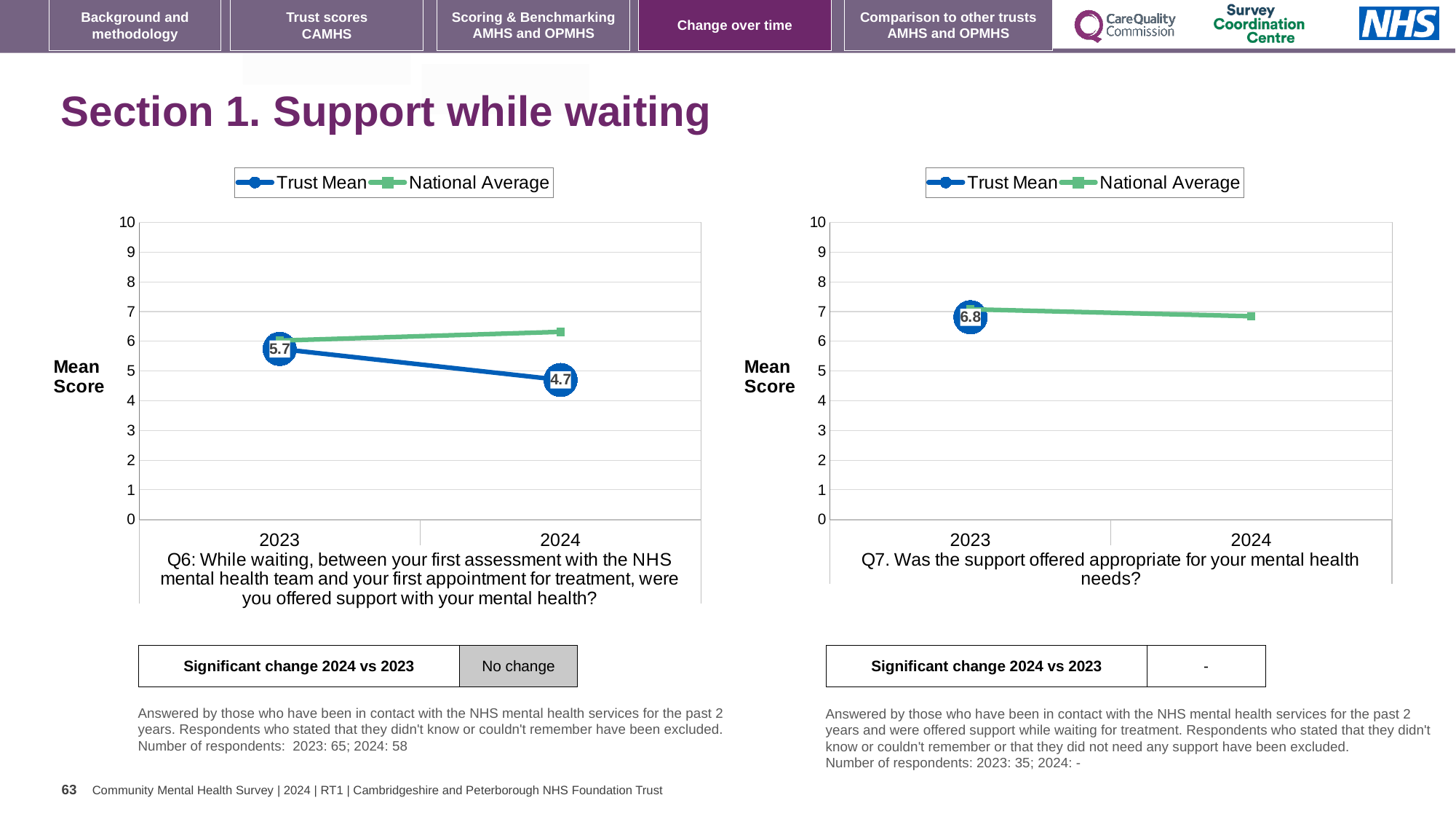
What is the label on the vertical axis of the left chart? Mean Score In the left chart (Q6), does the Trust Mean rise or fall from 2023 to 2024? fall What kind of chart is used on this slide? line chart In the right chart (Q7), is the National Average for 2023 greater or less than 6? greater In the left chart (Q6), what is the Trust Mean score for 2023? 5.7 How many series does the legend of the left chart list? 2 In the left chart (Q6), what is the Trust Mean score for 2024? 4.7 In the left chart (Q6), by how much did the Trust Mean fall from 2023 to 2024? 1.0 In the left chart (Q6), is the National Average for 2024 greater or less than 7? less In the right chart (Q7), what is the Trust Mean score for 2023? 6.8 How many years are shown on the x axis of the right chart (Q7)? 2 In the left chart (Q6), which is larger in 2024, the Trust Mean or the National Average? National Average